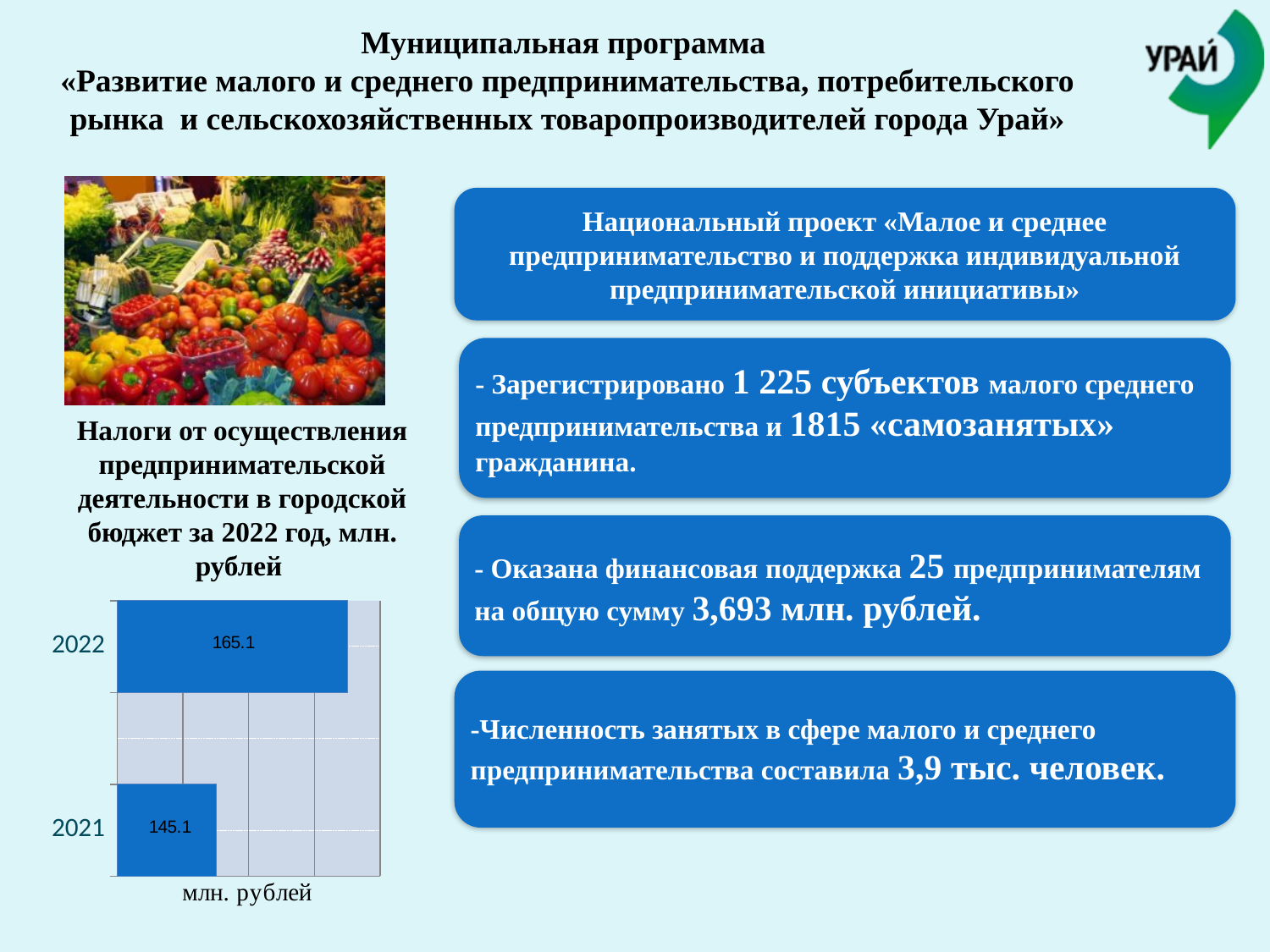
Which year has the lower value in the chart? 2021 Which year has the higher value in the chart? 2022 What kind of chart is shown on the slide? bar chart What is the value for 2021 in the chart? 145.1 Is the value for 2022 larger or smaller than the value for 2021? larger Did the value rise or fall from 2021 to 2022? rise What is the difference between the 2022 and 2021 values in the chart? 20.0 How many years (categories) are shown in the chart? 2 What colour are the bars in the chart? blue What unit is written below the chart's axis? млн. рублей What is the value for 2022 in the chart? 165.1